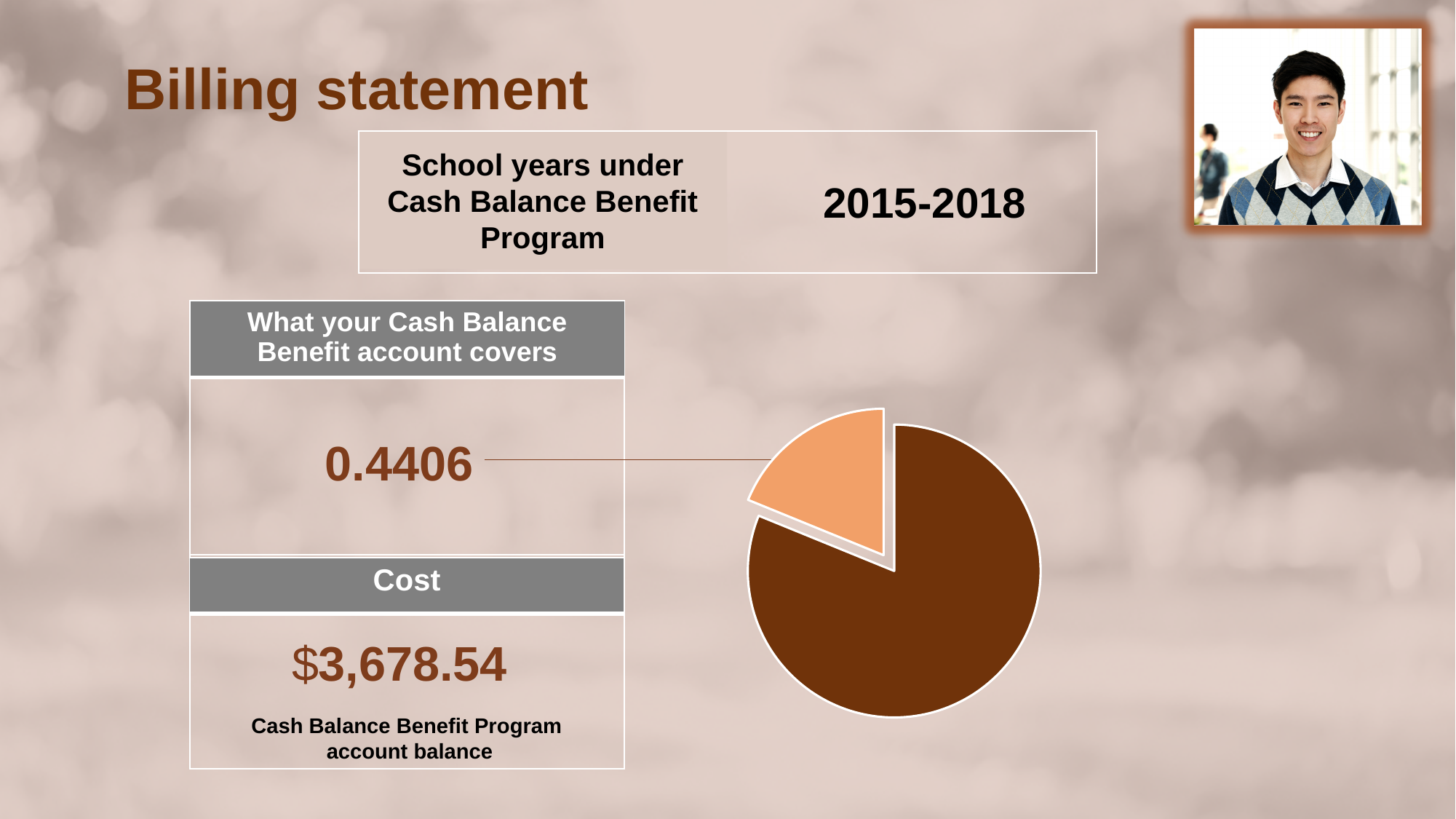
What kind of chart is shown on the slide? pie chart What value is connected by a line to the light orange slice of the pie chart? 0.4406 How many slices does the pie chart have? 2 Which slice of the pie chart is pulled out (exploded) from the rest of the pie? the light orange slice Which slice of the pie chart is the smallest? the light orange slice Which slice of the pie chart is larger, the dark brown one or the light orange one? the dark brown one Does the pie chart show a legend? No What two colours are used for the slices of the pie chart? dark brown and light orange